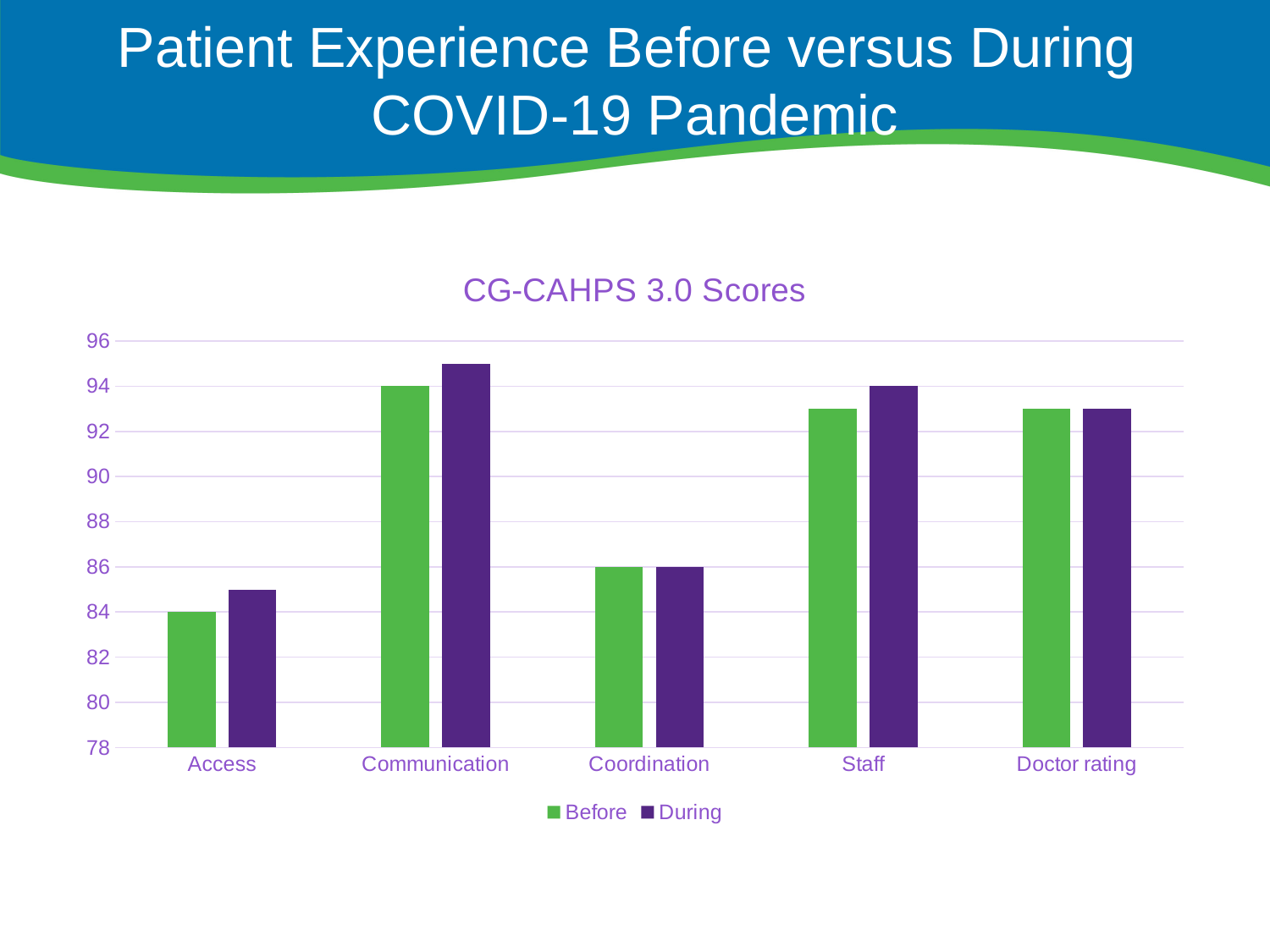
What is the During score for Staff? 94 Which category has the lowest Before score? Access What is the During score for Coordination? 86 What is the title of the chart? CG-CAHPS 3.0 Scores Which is larger, the Before score for Staff or the Before score for Coordination? Staff How many series does the legend list? 2 Is the During score for Communication greater or less than 94? greater What is the Before score for Communication? 94 What is the Before score for Access? 84 How many categories are shown on the x axis? 5 Which category has the highest During score? Communication What is the difference between the Before scores for Communication and Access? 10